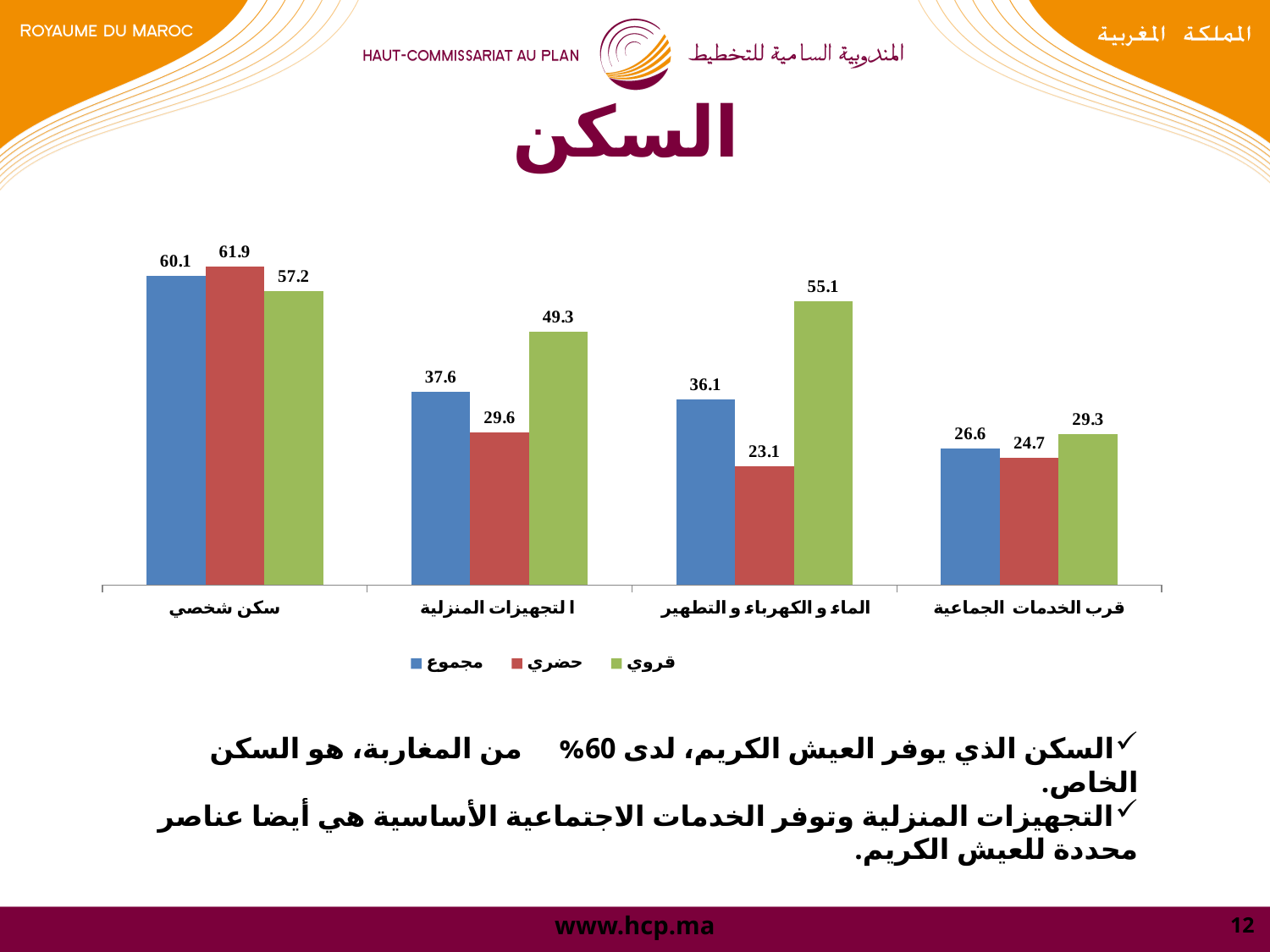
What is the value of the قروي series for الماء و الكهرباء و التطهير? 55.1 What is the difference between the قروي and حضري values for الماء و الكهرباء و التطهير? 32.0 For التجهيزات المنزلية, which is larger: the قروي value or the مجموع value? قروي What is the value of the حضري series for قرب الخدمات الجماعية? 24.7 How many series does the legend list? 3 What type of chart is shown on the slide? bar chart Which series is shown in green in the legend? قروي What is the value of the حضري series for التجهيزات المنزلية? 29.6 What is the value of the مجموع series for سكن شخصي? 60.1 Which category has the lowest value for the مجموع series? قرب الخدمات الجماعية Which category has the highest value for the حضري series? سكن شخصي How many categories are shown on the x axis? 4